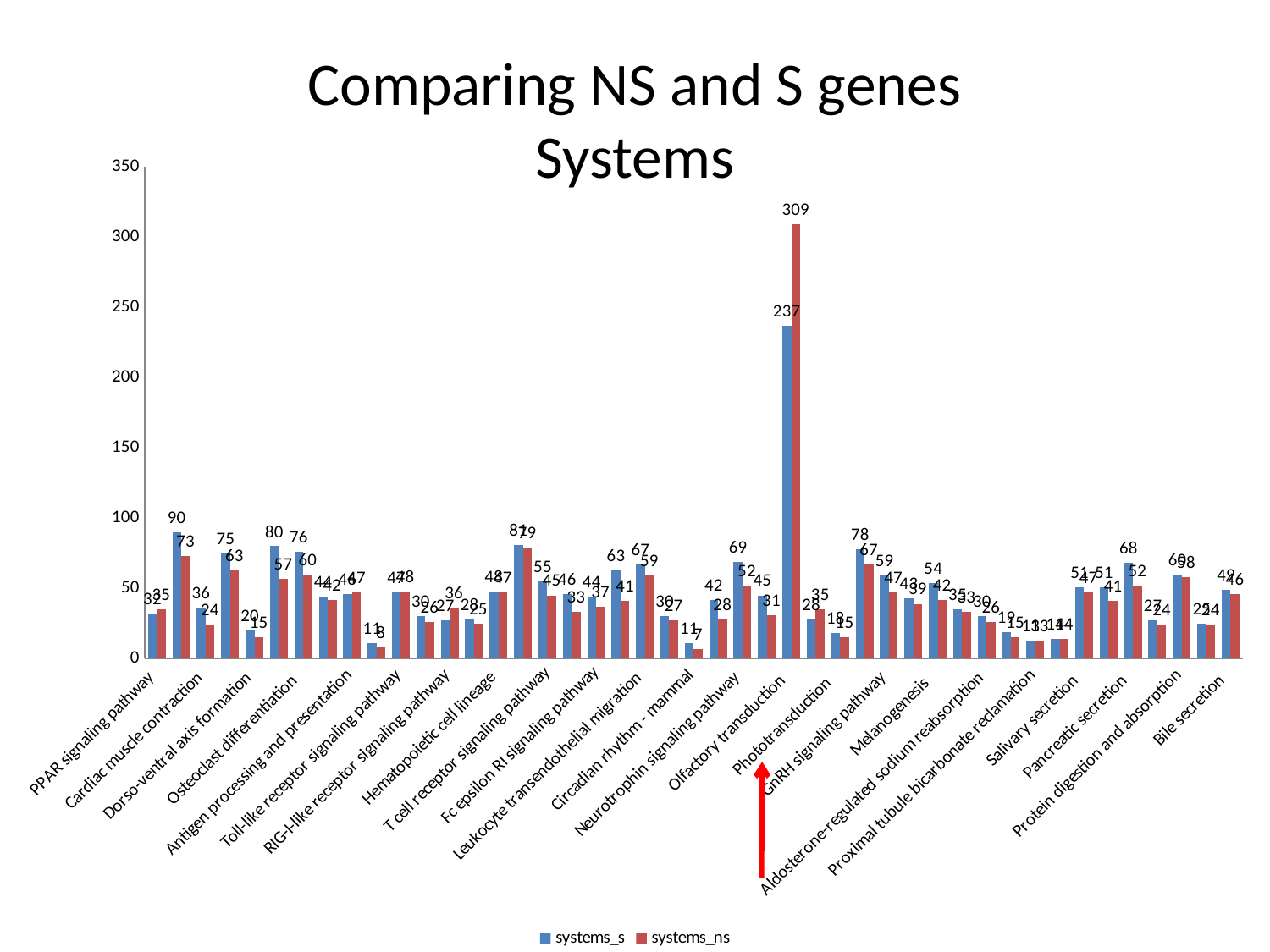
What is the title of the chart? Comparing NS and S genes Systems What is the systems_ns value for PPAR signaling pathway? 35 For Olfactory transduction, which is larger: systems_s or systems_ns? systems_ns What is the difference between the systems_ns and systems_s values for Olfactory transduction? 72 What is the systems_ns value for Olfactory transduction? 309 Is the systems_ns value for Olfactory transduction greater or less than 300? greater Which category has the highest systems_ns value? Olfactory transduction Which category has the highest systems_s value? Olfactory transduction How many series does the legend list? 2 What type of chart is shown on the slide? bar chart What is the systems_s value for Olfactory transduction? 237 What are the two series named in the legend? systems_s and systems_ns